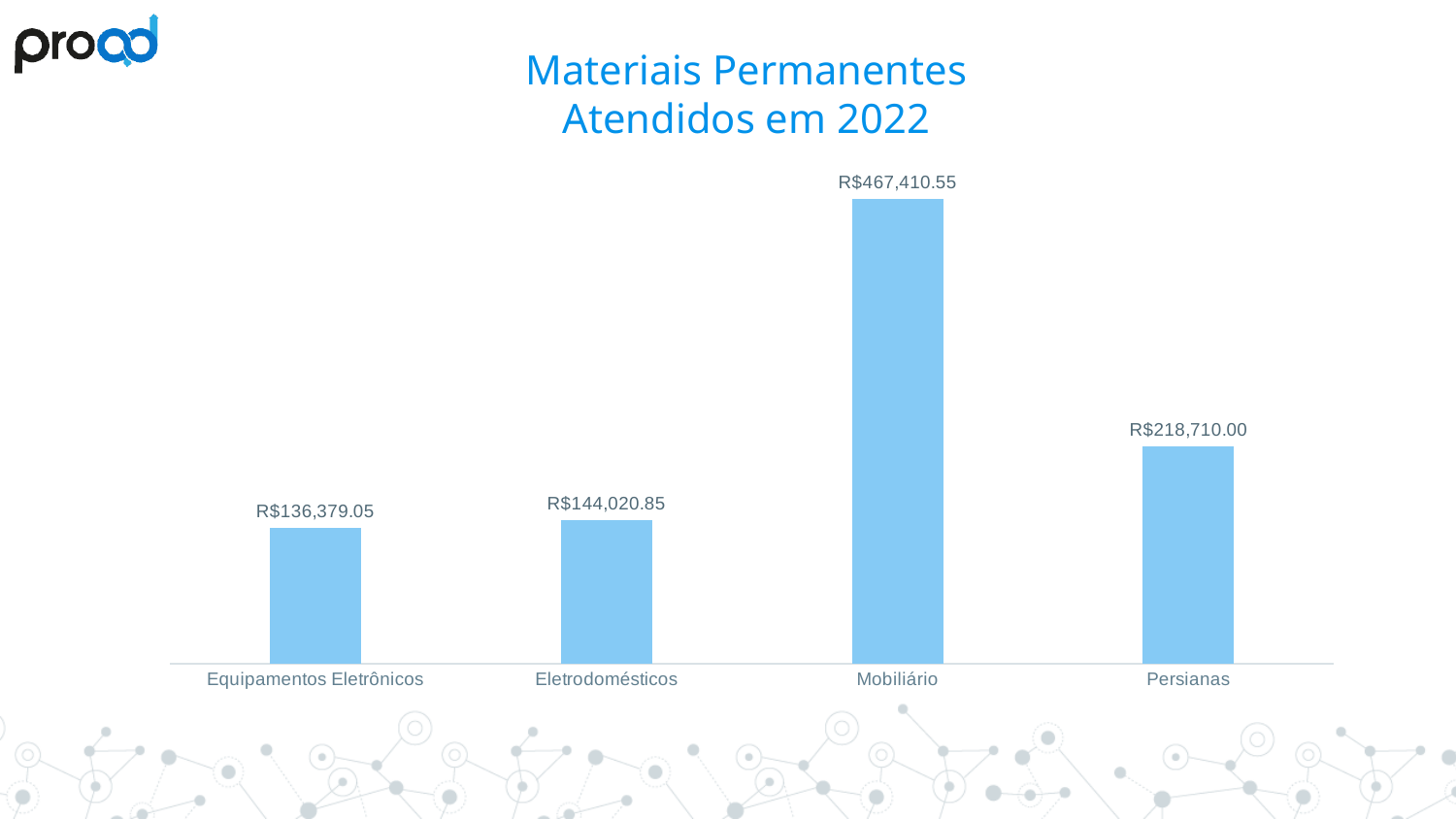
Which category has the highest value? Mobiliário What is the value for Equipamentos Eletrônicos? R$136,379.05 What is the title of the chart? Materiais Permanentes Atendidos em 2022 How many categories are shown in the chart? 4 What is the difference between the values for Eletrodomésticos and Equipamentos Eletrônicos? R$7,641.80 What is the value for Eletrodomésticos? R$144,020.85 What is the difference between the values for Mobiliário and Persianas? R$248,700.55 What kind of chart is shown on the slide? Bar chart Which is larger, the value for Persianas or the value for Eletrodomésticos? Persianas What is the value for Persianas? R$218,710.00 What is the value for Mobiliário? R$467,410.55 Which category has the lowest value? Equipamentos Eletrônicos